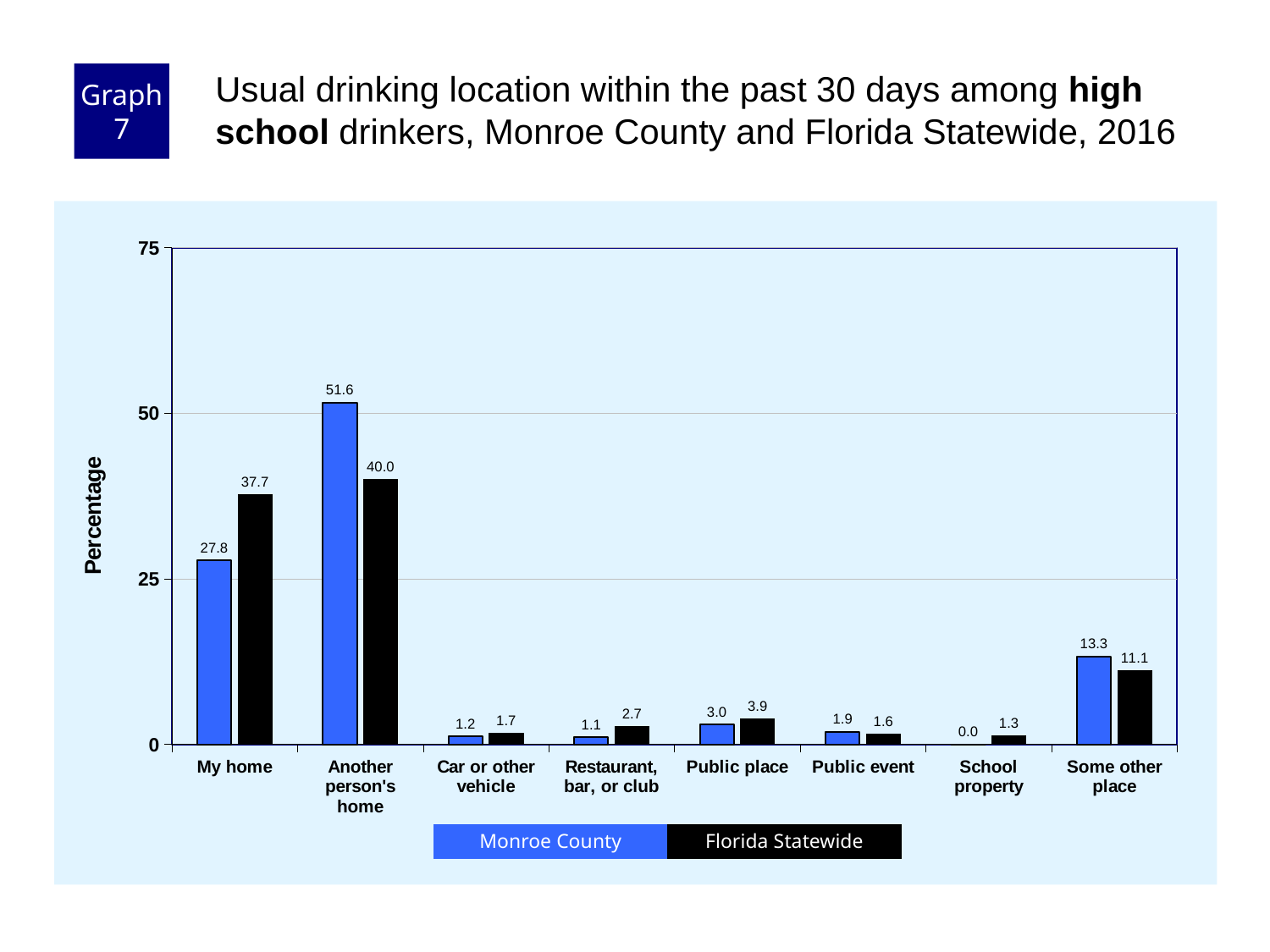
What is the Florida Statewide value for "My home"? 37.7 Is the Monroe County value for "Another person's home" greater or less than 50? greater What is the difference between the Monroe County and Florida Statewide values for "Another person's home"? 11.6 What colour represents Florida Statewide in the chart? Black For "Public place", which is larger: Monroe County or Florida Statewide? Florida Statewide How many categories are shown on the x axis? 8 How many series does the legend list? 2 What kind of chart is shown on the slide? Bar chart Which category has the highest Monroe County value? Another person's home What is the Monroe County value for "School property"? 0.0 Which category has the lowest Florida Statewide value? School property What is the Monroe County value for "Another person's home"? 51.6